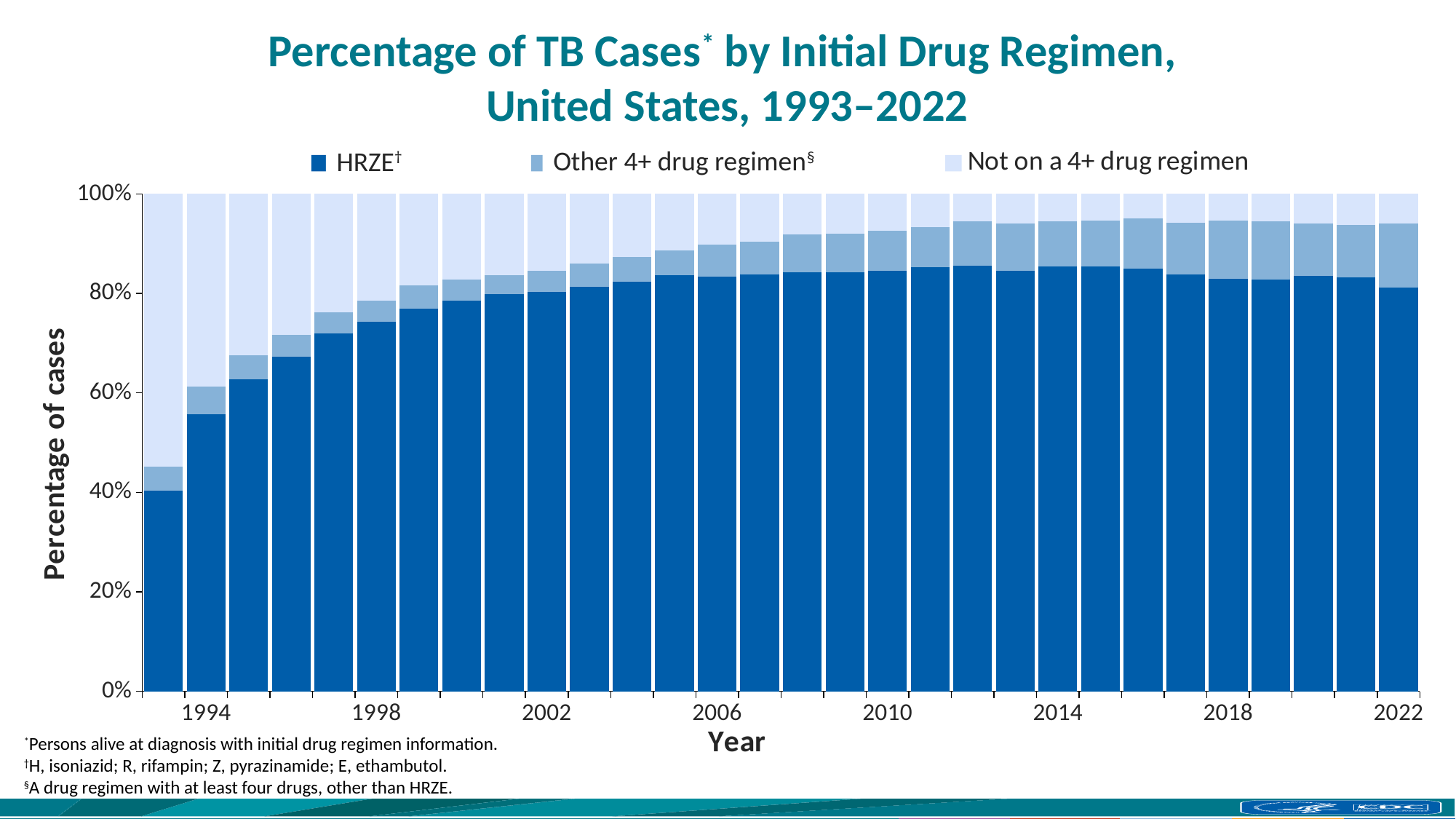
Is the HRZE value for 1993 greater or less than 60%? less What is the total of the stacked bar for 2022? 100% Is the HRZE value for 1994 greater or less than 40%? greater What are the three series listed in the legend? HRZE, Other 4+ drug regimen, Not on a 4+ drug regimen Which year has a larger HRZE share, 1993 or 2022? 2022 What kind of chart is shown on the slide? Stacked bar chart Is the HRZE value for 2022 greater or less than 60%? greater How many series does the legend list? 3 How many years (bars) are plotted on the chart? 30 In which year is the 'Not on a 4+ drug regimen' share largest? 1993 Does the HRZE share rise or fall from 1993 to 2000? rise In which year is the HRZE share lowest? 1993